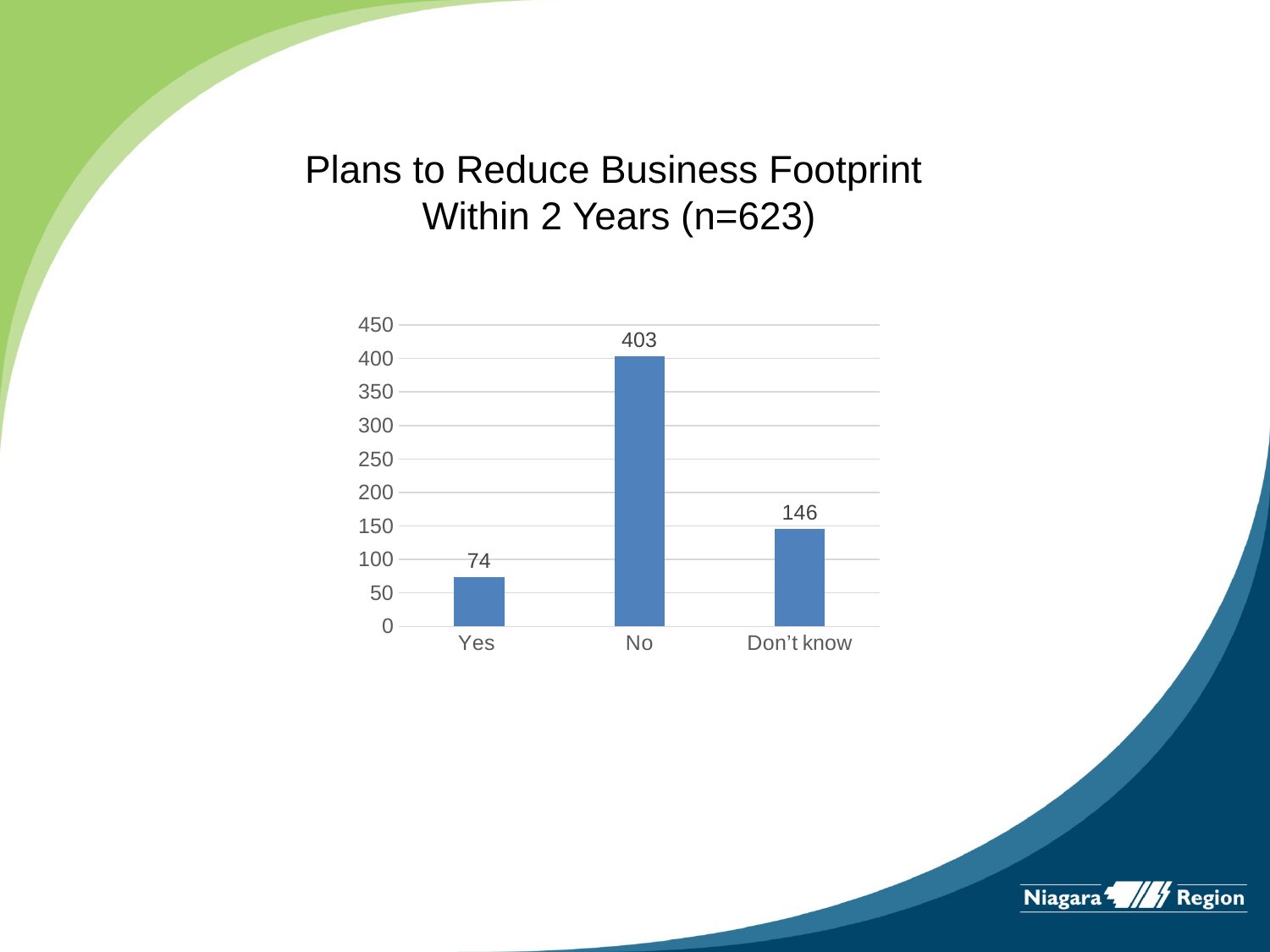
Which category has the highest value? No What is the title of the chart? Plans to Reduce Business Footprint Within 2 Years (n=623) What is the difference between the values for "No" and "Don't know"? 257 What kind of chart is shown on the slide? bar chart Which is larger, the value for "Yes" or the value for "Don't know"? Don't know What is the value for "Don't know"? 146 How many categories are shown on the x axis? 3 What is the value for "Yes"? 74 What is the difference between the values for "Don't know" and "Yes"? 72 What is the value for "No"? 403 Is the value for "No" greater or less than 400? greater Which category has the lowest value? Yes